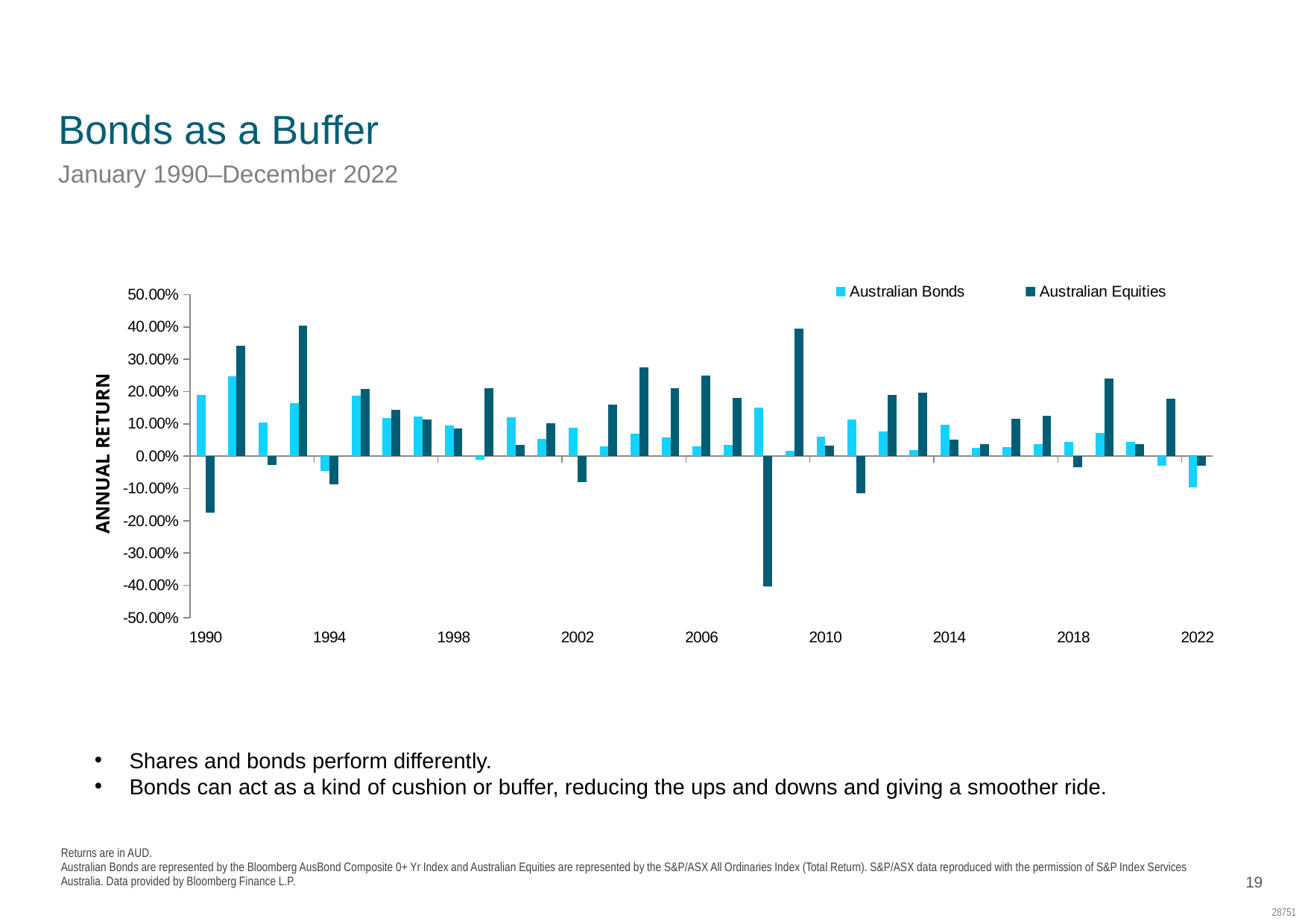
In which year is the Australian Bonds return lowest? 2022 Is the Australian Bonds value for 1991 greater or less than 20.00%? greater Is the Australian Equities value for 2008 greater or less than -30.00%? less In which year is the Australian Equities return lowest? 2008 What is the title of the vertical axis? ANNUAL RETURN In 1991, which is larger: the Australian Bonds return or the Australian Equities return? Australian Equities How many series does the legend list? 2 In 2008, which is larger: the Australian Bonds return or the Australian Equities return? Australian Bonds Is the Australian Equities value for 1993 greater or less than 30.00%? greater In which year is the Australian Bonds return highest? 1991 Which series is shown in the darker teal bars? Australian Equities What kind of chart is shown on the slide? bar chart